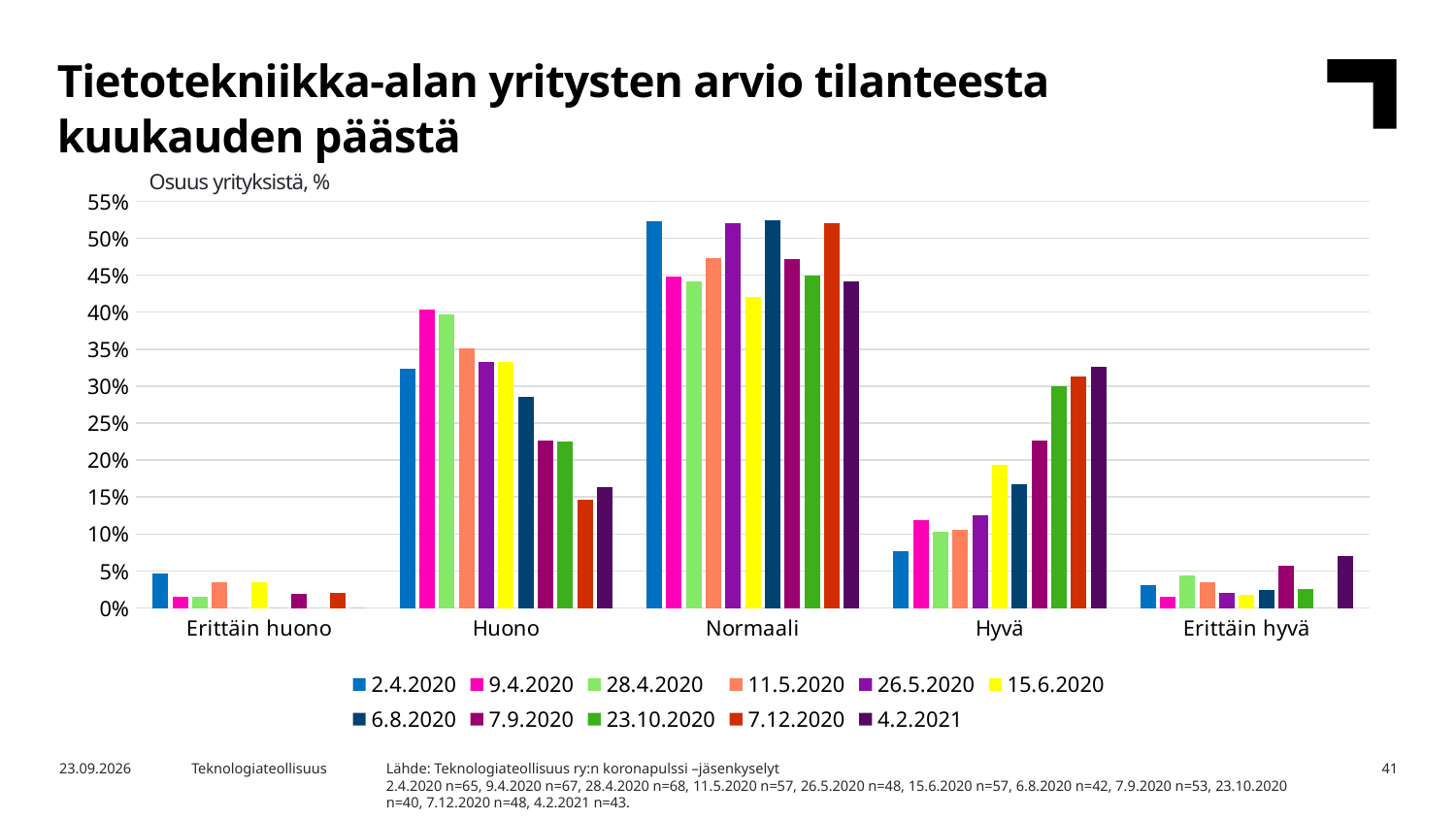
How many categories are shown on the x axis? 5 Which is larger in the Hyvä category: the value for 2.4.2020 or the value for 4.2.2021? 4.2.2021 Is the value for 4.2.2021 in the Erittäin hyvä category greater or less than 5%? greater Which category has the tallest bars overall? Normaali What is the label shown on the vertical axis of the chart? Osuus yrityksistä, % Across the survey dates from 2.4.2020 to 4.2.2021, do the values in the Hyvä category generally rise or fall? rise Is the value for 2.4.2020 in the Huono category greater or less than 30%? greater Is the value for 2.4.2020 in the Normaali category greater or less than 50%? greater How many series does the legend list? 11 Which is larger in the Huono category: the value for 2.4.2020 or the value for 4.2.2021? 2.4.2020 What kind of chart is shown on the slide? bar chart